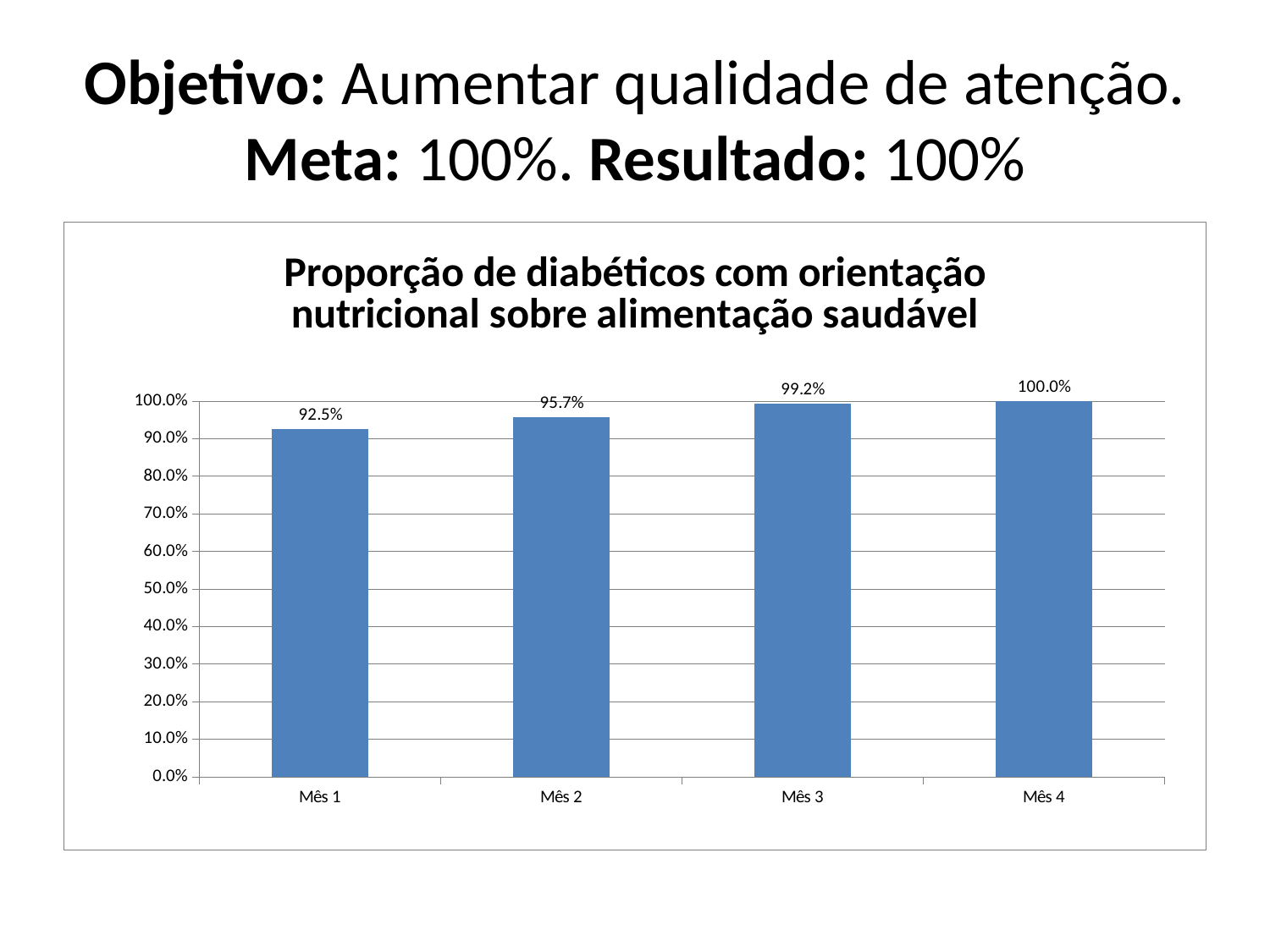
What is the value for Mês 4? 100.0% Which month has the highest value? Mês 4 What is the value for Mês 3? 99.2% What is the value for Mês 2? 95.7% What is the difference between the values for Mês 4 and Mês 1? 7.5% Which is larger, the value for Mês 2 or the value for Mês 3? Mês 3 Do the values rise or fall from Mês 1 to Mês 4? Rise How many months are shown on the x axis? 4 Which month has the lowest value? Mês 1 What is the value for Mês 1? 92.5% What kind of chart is this? Bar chart What is the difference between the values for Mês 2 and Mês 1? 3.2%